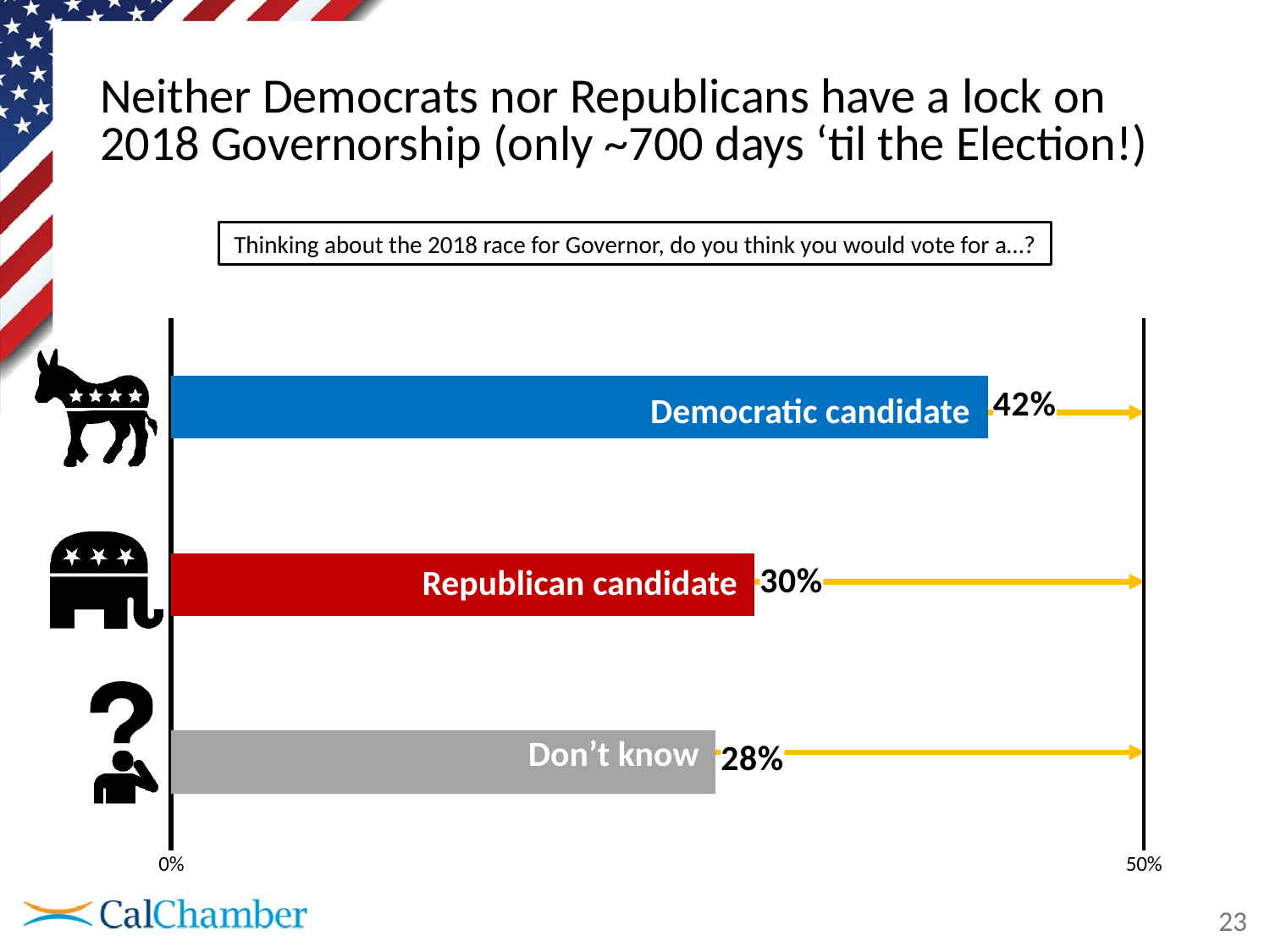
How many response categories are shown in the chart? 3 What kind of chart is shown on the slide? Bar chart What is the difference in percentage points between the Republican candidate and Don't know? 2 What is the difference in percentage points between the Democratic candidate and the Republican candidate? 12 Which response has the highest percentage? Democratic candidate What colour is the bar for the Republican candidate? Red What percentage of respondents said they would vote for a Republican candidate? 30% Which response has the lowest percentage? Don't know What percentage of respondents answered Don't know? 28% What percentage of respondents said they would vote for a Democratic candidate? 42% What is the maximum value shown on the chart's horizontal axis? 50% Which is larger, the value for Democratic candidate or the value for Don't know? Democratic candidate